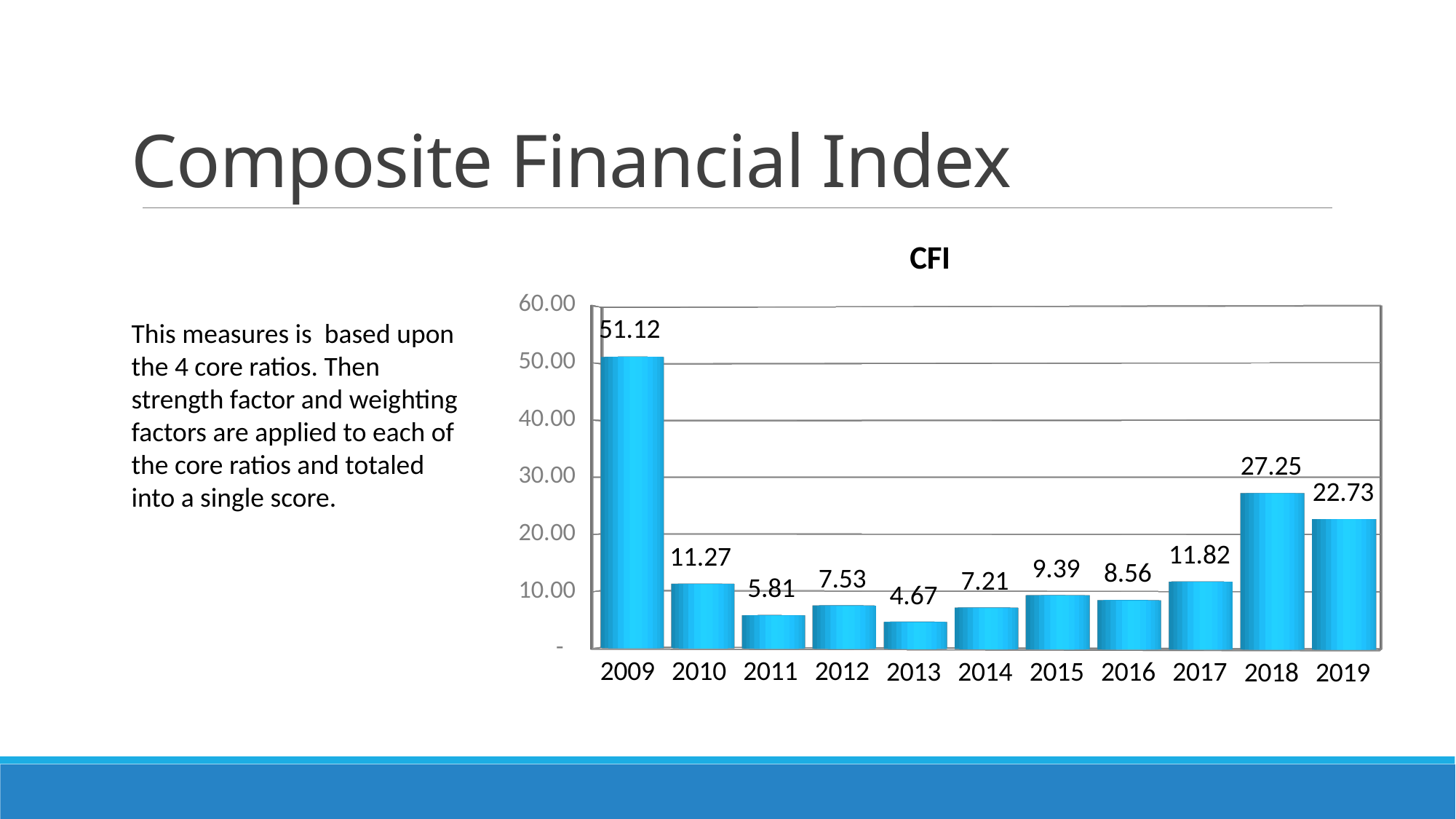
What kind of chart is shown on the slide? bar chart Which year has the lowest CFI value? 2013 What is the CFI value for 2013? 4.67 Which year has the highest CFI value? 2009 How many years are shown on the x axis of the chart? 11 What is the CFI value for 2009? 51.12 What is the CFI value for 2018? 27.25 Is the CFI value for 2017 greater or less than 10.00? greater Does the CFI value rise or fall from 2017 to 2018? rise What is the difference between the CFI values for 2018 and 2019? 4.52 Which year has a larger CFI value, 2015 or 2016? 2015 What is the title of the chart? CFI